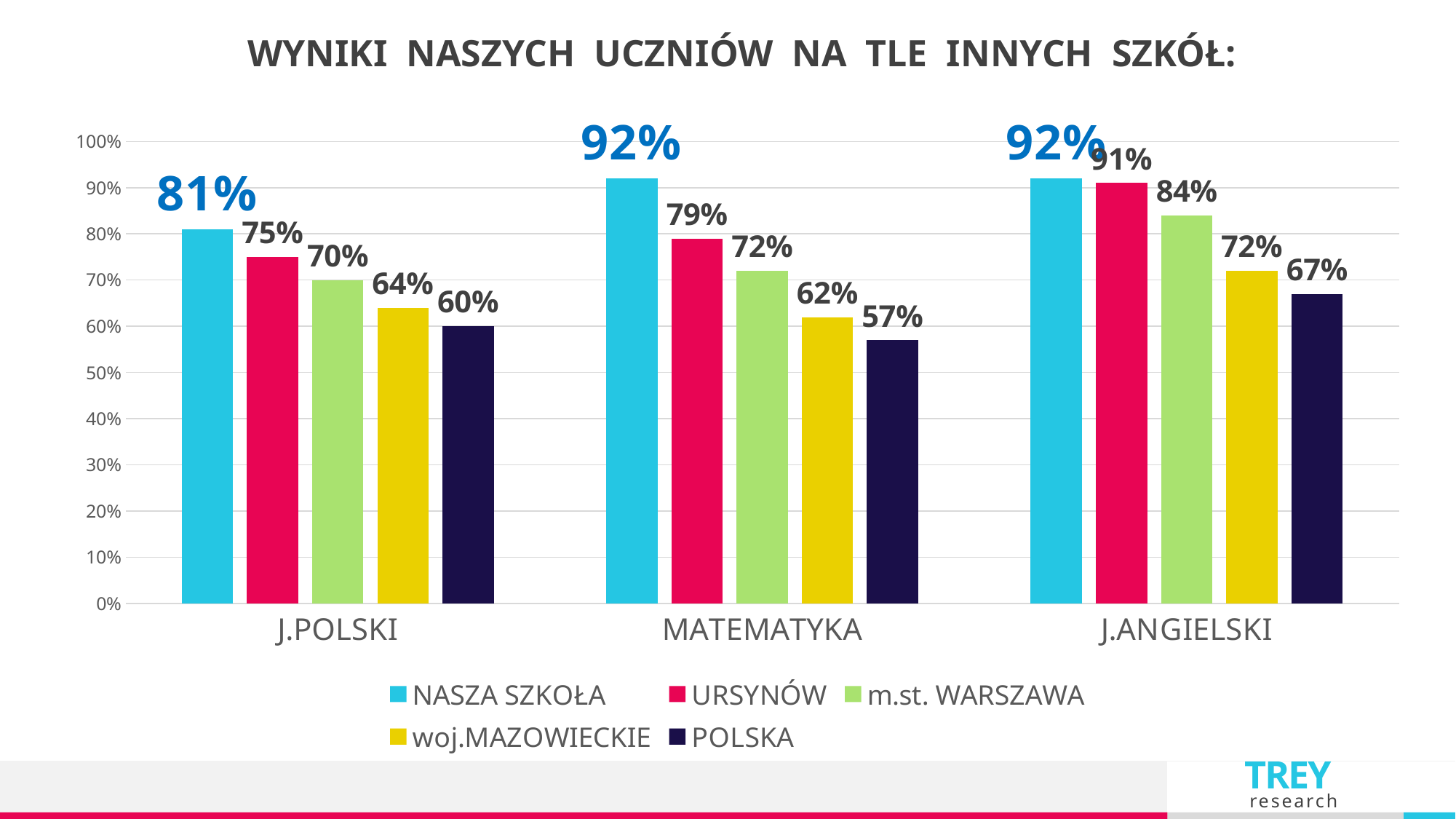
What is the value for NASZA SZKOŁA in J.POLSKI? 81% Which is larger: woj.MAZOWIECKIE in J.ANGIELSKI or woj.MAZOWIECKIE in J.POLSKI? woj.MAZOWIECKIE in J.ANGIELSKI What is the value for m.st. WARSZAWA in J.ANGIELSKI? 84% How many series does the legend list? 5 Which series has the lowest value in J.POLSKI? POLSKA What kind of chart is shown on the slide? Bar chart What is the value for POLSKA in MATEMATYKA? 57% What is the value for URSYNÓW in MATEMATYKA? 79% How many categories are shown on the x axis? 3 What is the difference between NASZA SZKOŁA and POLSKA in MATEMATYKA? 35% What is the title of the chart? WYNIKI NASZYCH UCZNIÓW NA TLE INNYCH SZKÓŁ: Which series has the highest value in J.ANGIELSKI? NASZA SZKOŁA